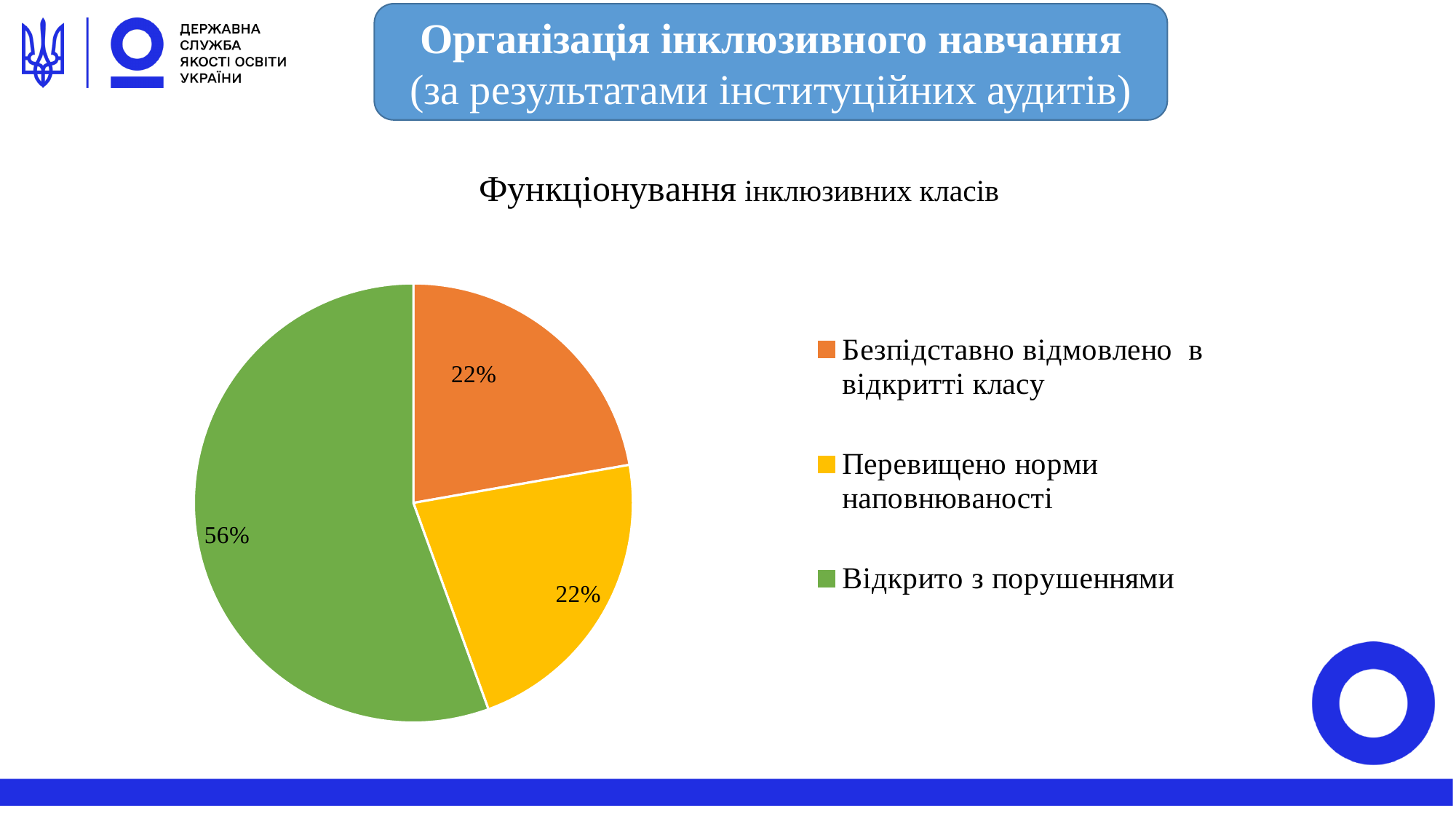
What is the value for "Безпідставно відмовлено в відкритті класу"? 22% What share of the pie does "Відкрито з порушеннями" take? 56% What kind of chart is shown on the slide? pie chart How many slices does the pie chart have? 3 Which category has the largest slice of the pie? Відкрито з порушеннями What is the value for "Перевищено норми наповнюваності"? 22% What colour is the slice for "Перевищено норми наповнюваності"? yellow Is the share for "Відкрито з порушеннями" greater or less than 50%? greater What is the difference between the share for "Відкрито з порушеннями" and the share for "Перевищено норми наповнюваності"? 34% What is the title of the chart? Функціонування інклюзивних класів How many entries does the legend list? 3 Which is larger: the slice for "Відкрито з порушеннями" or the slice for "Безпідставно відмовлено в відкритті класу"? Відкрито з порушеннями